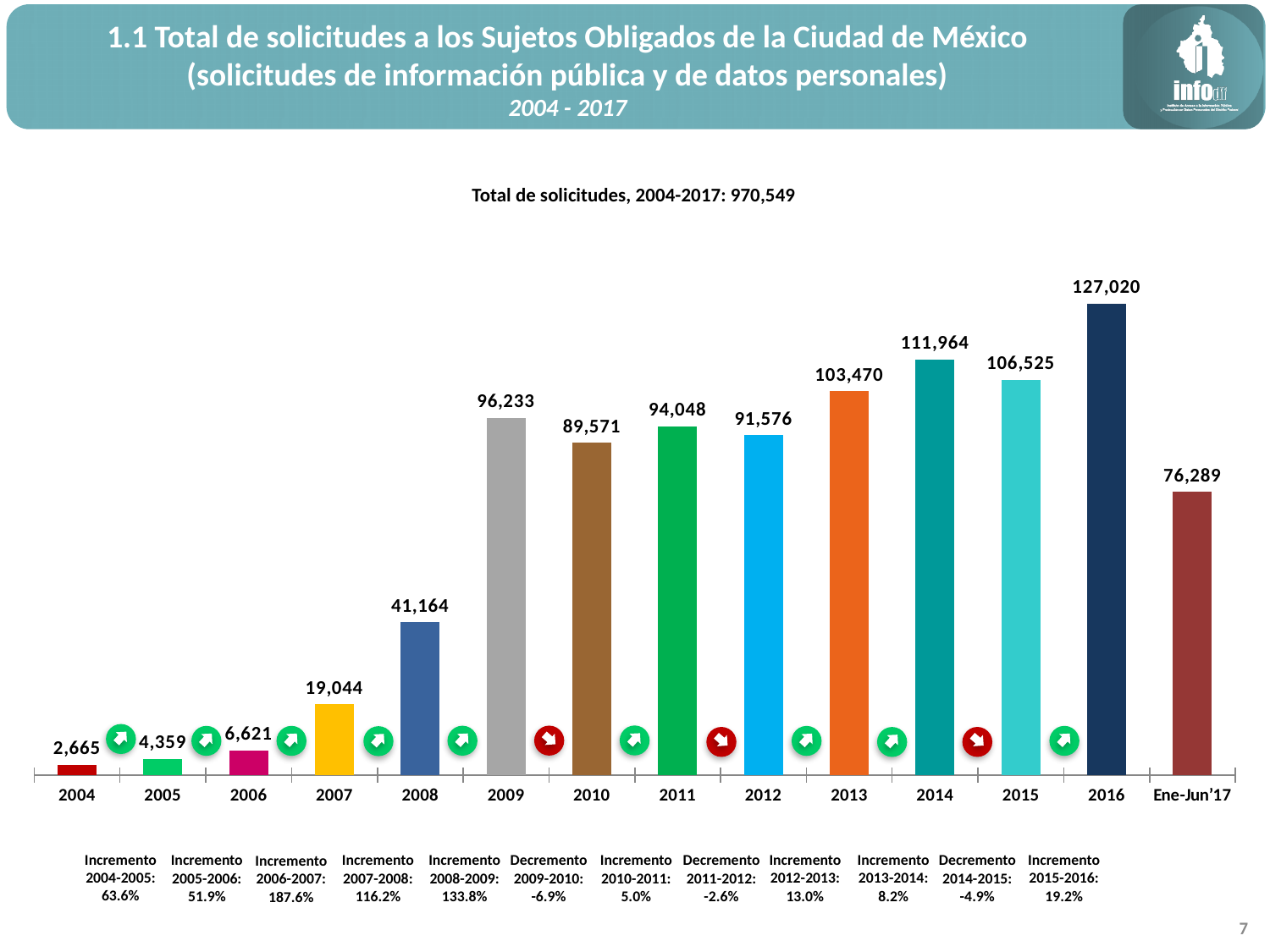
What is the difference between the values for 2009 and 2008? 55,069 Which year has the highest value? 2016 What type of chart is shown on the slide? Bar chart How many bars (periods) are plotted in the chart? 14 What is the value for 2009? 96,233 What is the value for 2004? 2,665 What is the difference between the values for 2016 and 2015? 20,495 Which year has the lowest value? 2004 What is the value for Ene-Jun'17? 76,289 What is the value for 2016? 127,020 Which is larger, the value for 2010 or the value for 2011? 2011 What total of solicitudes for 2004-2017 is stated above the chart? 970,549